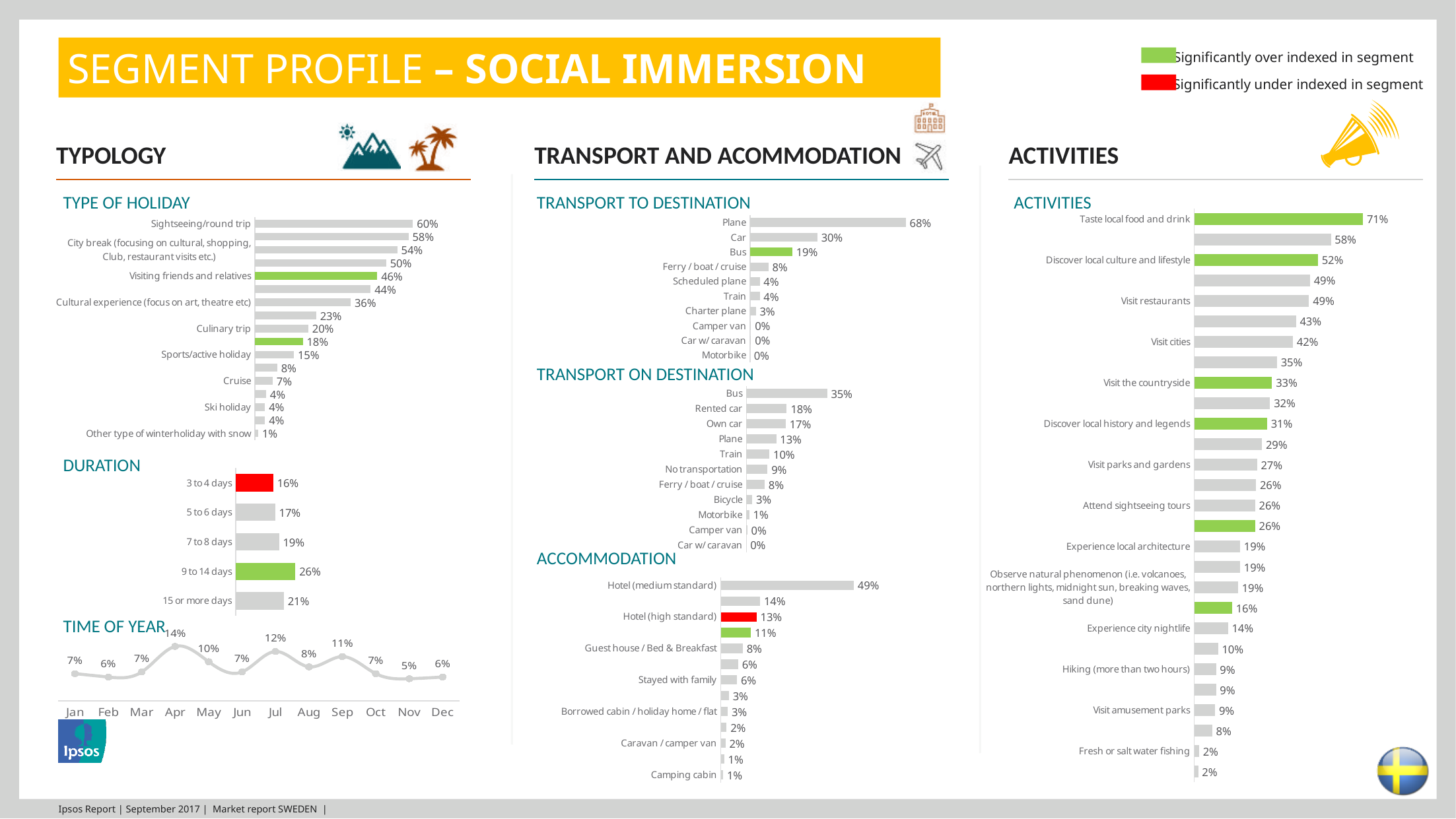
In the Transport on Destination chart, which category has the highest value? Bus In the Duration chart, which duration category has the lowest value? 3 to 4 days In the Duration chart, what is the value for 9 to 14 days? 26% In the Activities chart, what is the difference between the values for Taste local food and drink and Discover local culture and lifestyle? 19% In the Duration chart, what is the difference between the values for 9 to 14 days and 3 to 4 days? 10% In the Transport to Destination chart, which is larger, the value for Car or the value for Bus? Car In the Time of Year chart, which month has the highest value? Apr What kind of chart is the Time of Year chart? Line chart In the Accommodation chart, what is the value for Hotel (medium standard)? 49% In the Activities chart, what is the value for Taste local food and drink? 71% In the Transport on Destination chart, what is the value for Rented car? 18% In the Transport to Destination chart, what is the value for Plane? 68%